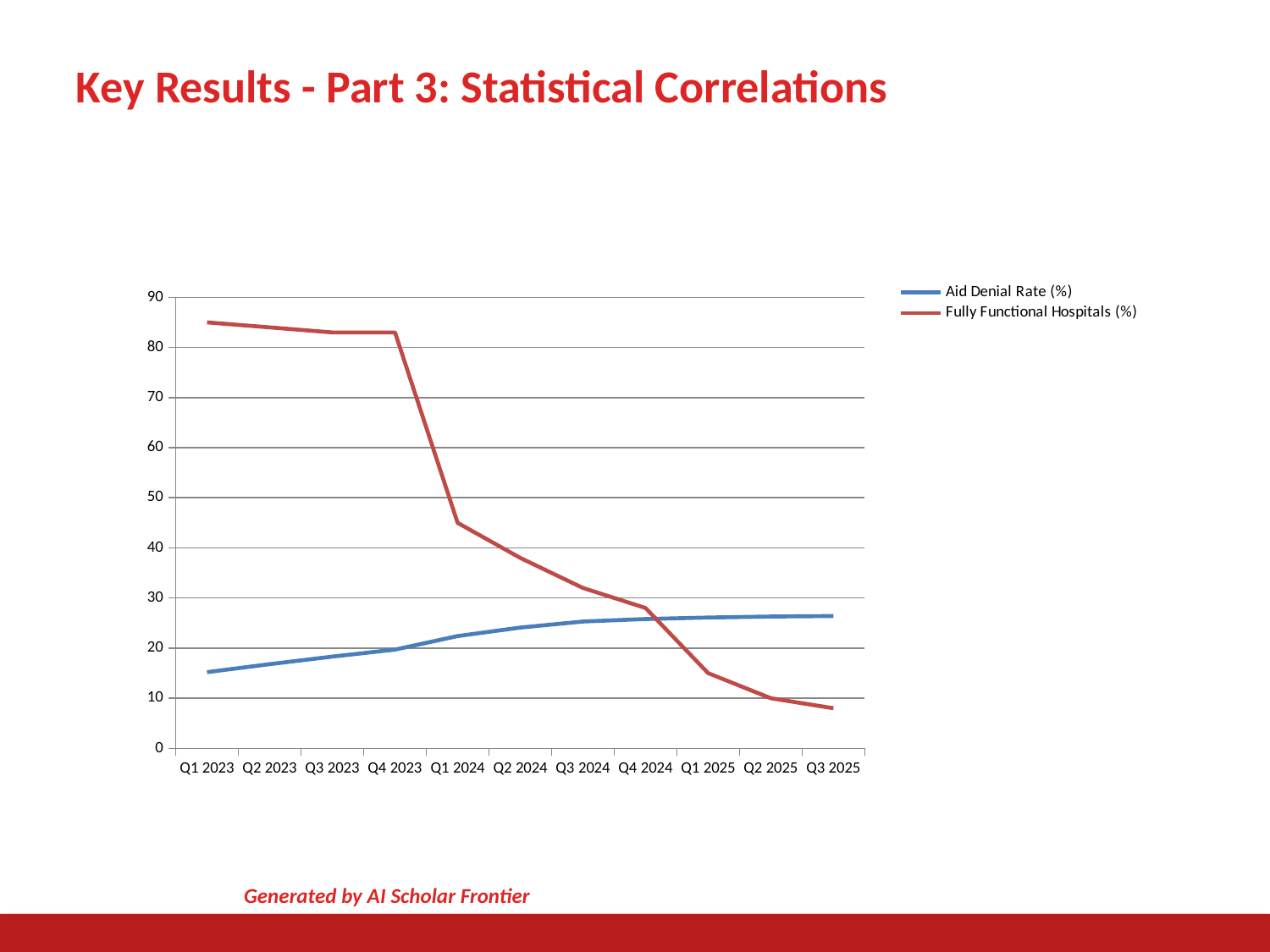
Does the Aid Denial Rate (%) line rise or fall from Q1 2023 to Q3 2025? rise What kind of chart is shown on the slide? line chart How many series does the legend list? 2 Is the value for Fully Functional Hospitals (%) in Q1 2023 greater or less than 80? greater In which quarter is the Fully Functional Hospitals (%) value lowest? Q3 2025 In Q1 2024, which series has the higher value, Aid Denial Rate (%) or Fully Functional Hospitals (%)? Fully Functional Hospitals (%) Does the Fully Functional Hospitals (%) line rise or fall from Q1 2023 to Q3 2025? fall What colour is the Aid Denial Rate (%) line? blue How many quarters are shown along the x axis? 11 Is the value for Fully Functional Hospitals (%) in Q3 2025 greater or less than 10? less In Q2 2025, which series has the higher value, Aid Denial Rate (%) or Fully Functional Hospitals (%)? Aid Denial Rate (%) Is the value for Aid Denial Rate (%) in Q1 2023 greater or less than 20? less